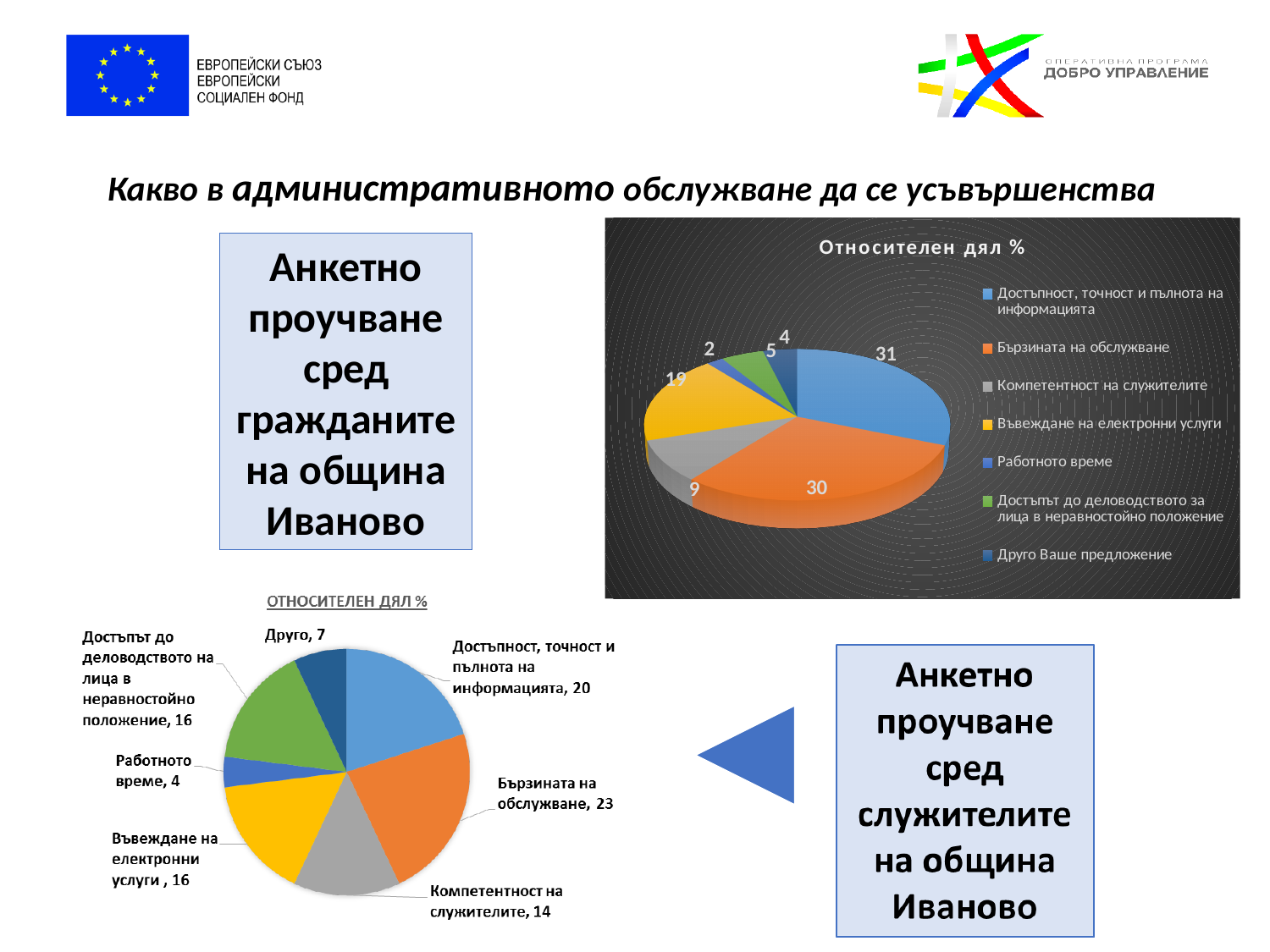
In the pie chart at the bottom left of the slide, what is the value for Компетентност на служителите? 14 In the pie chart at the top right of the slide, which category has the smallest value? Работното време In the pie chart at the bottom left of the slide, what is the value for Бързината на обслужване? 23 What type of chart is shown at the bottom left of the slide? Pie chart In the pie chart at the top right of the slide, what is the difference between the values for Въвеждане на електронни услуги and Компетентност на служителите? 10 In the pie chart at the bottom left of the slide, what is the difference between the values for Бързината на обслужване and Достъпност, точност и пълнота на информацията? 3 In the pie chart at the top right of the slide, what is the value for Бързината на обслужване? 30 In the pie chart at the bottom left of the slide, which category has the smallest value? Работното време How many categories does the legend of the pie chart at the top right of the slide list? 7 In the pie chart at the top right of the slide, which category has the largest value? Достъпност, точност и пълнота на информацията In the pie chart at the top right of the slide, what is the value for Въвеждане на електронни услуги? 19 In the pie chart at the bottom left of the slide, which is larger: Друго or Работното време? Друго